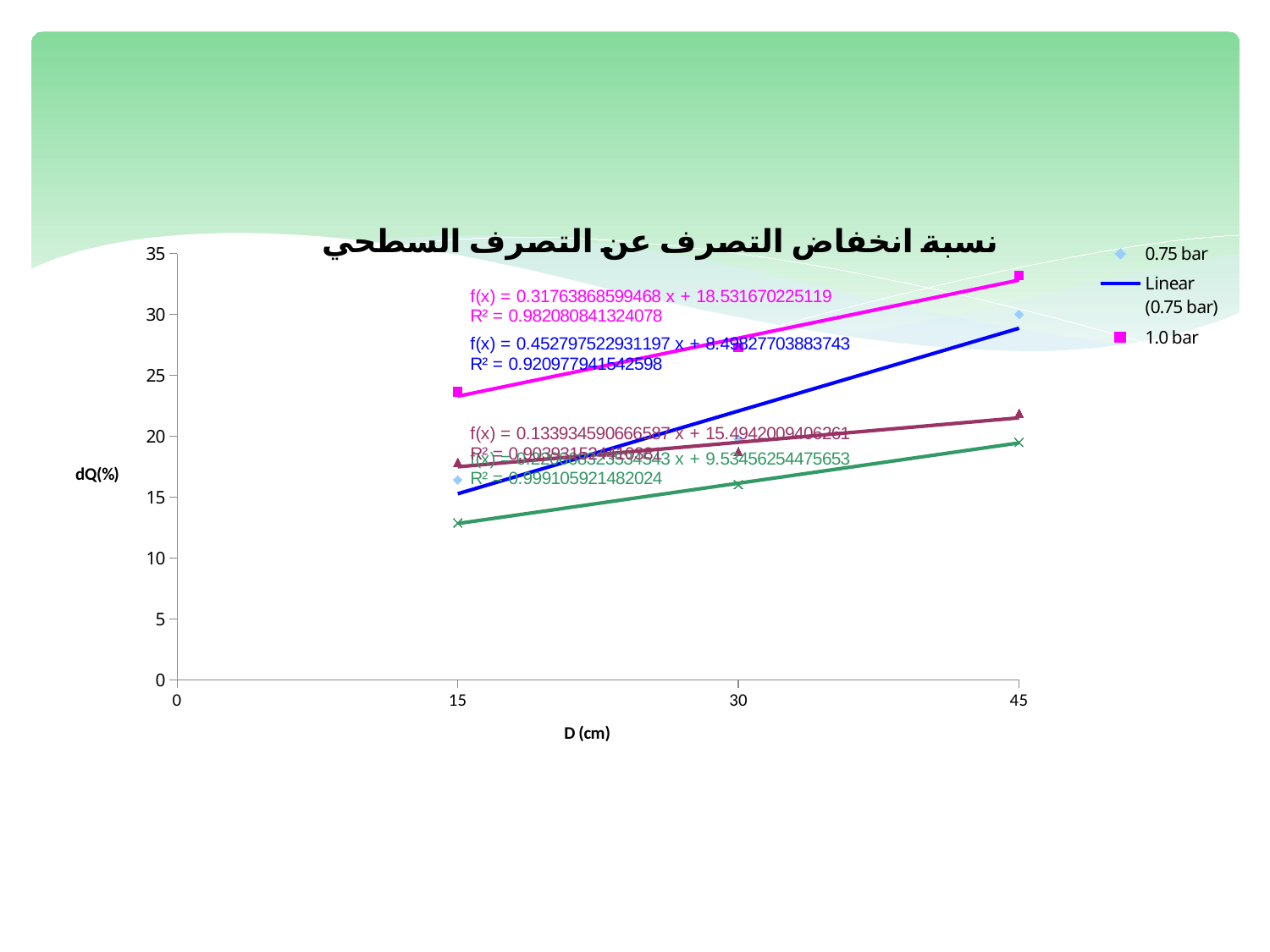
Is the value for the 0.75 bar series at D = 15 cm greater or less than 20? less What is the title of the y axis? dQ(%) At which D value does the 1.0 bar series reach its highest value? 45 Do the values for the 1.0 bar series rise or fall as D increases? Rise Do the values for the 0.75 bar series rise or fall as D increases? Rise Is the value for the 1.0 bar series at D = 45 cm greater or less than 30? greater What kind of chart is shown on the slide? Scatter chart with linear trendlines What is the title of the x axis? D (cm) Is the value for the 1.0 bar series at D = 15 cm greater or less than 20? greater At D = 45 cm, which series has the larger value, 1.0 bar or 0.75 bar? 1.0 bar At how many D values are points plotted for the 1.0 bar series? 3 What R² value is printed for the magenta (1.0 bar) trendline? 0.982080841324078